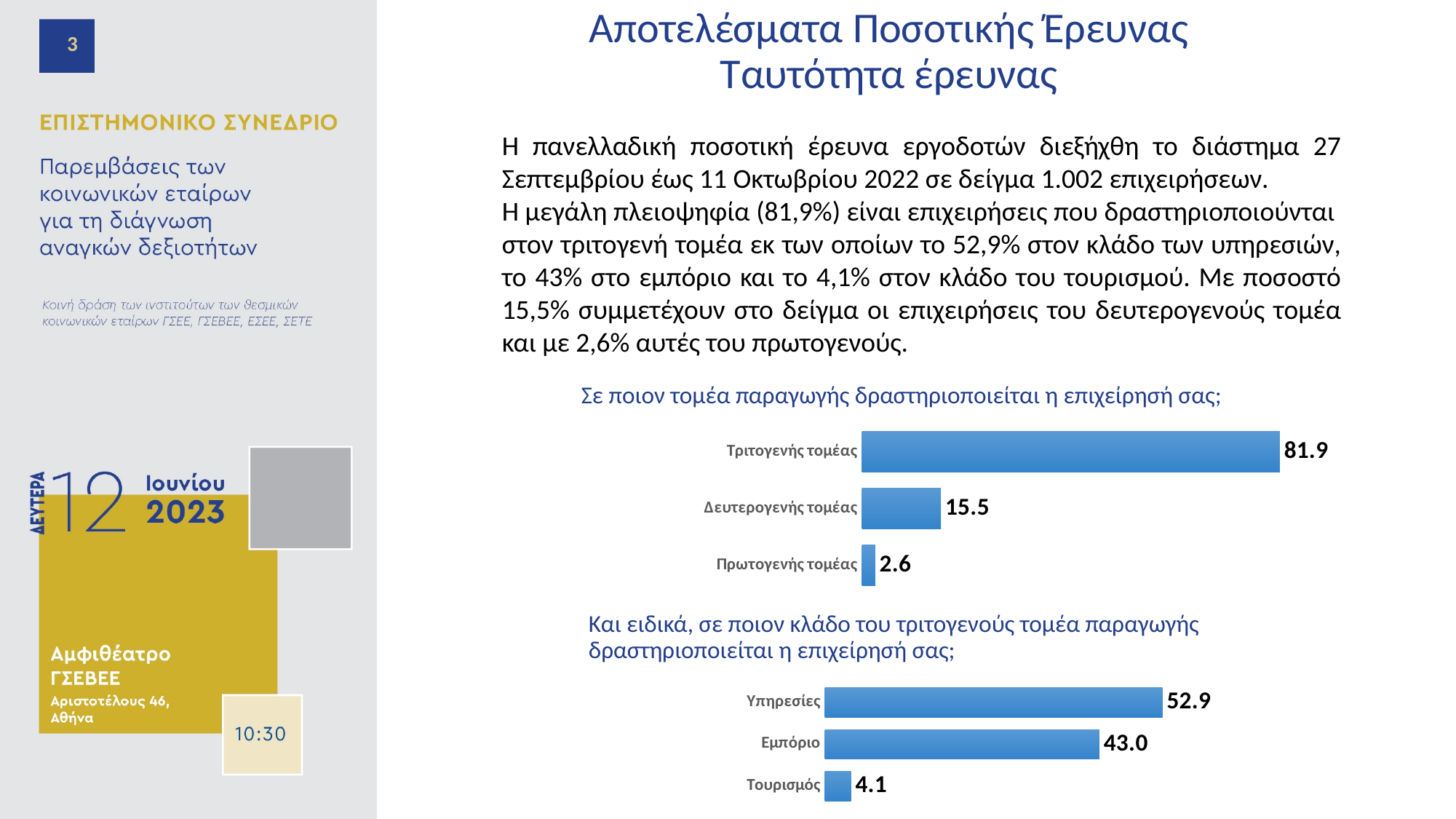
In the bottom chart, which category has the highest value? Υπηρεσίες In the bottom chart, what is the difference between the values for Υπηρεσίες and Εμπόριο? 9.9 In the bottom chart (Και ειδικά, σε ποιον κλάδο του τριτογενούς τομέα παραγωγής δραστηριοποιείται η επιχείρησή σας;), what is the value for Υπηρεσίες? 52.9 In the top chart, what is the value for Πρωτογενής τομέας? 2.6 In the top chart, how many categories are shown? 3 In the bottom chart, which is larger: the value for Εμπόριο or the value for Τουρισμός? Εμπόριο In the top chart, what is the value for Δευτερογενής τομέας? 15.5 What type of chart is the top chart on the slide? Bar chart In the top chart, what is the difference between the values for Τριτογενής τομέας and Δευτερογενής τομέας? 66.4 In the top chart, which category has the lowest value? Πρωτογενής τομέας In the top chart (Σε ποιον τομέα παραγωγής δραστηριοποιείται η επιχείρησή σας;), what is the value for Τριτογενής τομέας? 81.9 In the bottom chart, what is the value for Τουρισμός? 4.1